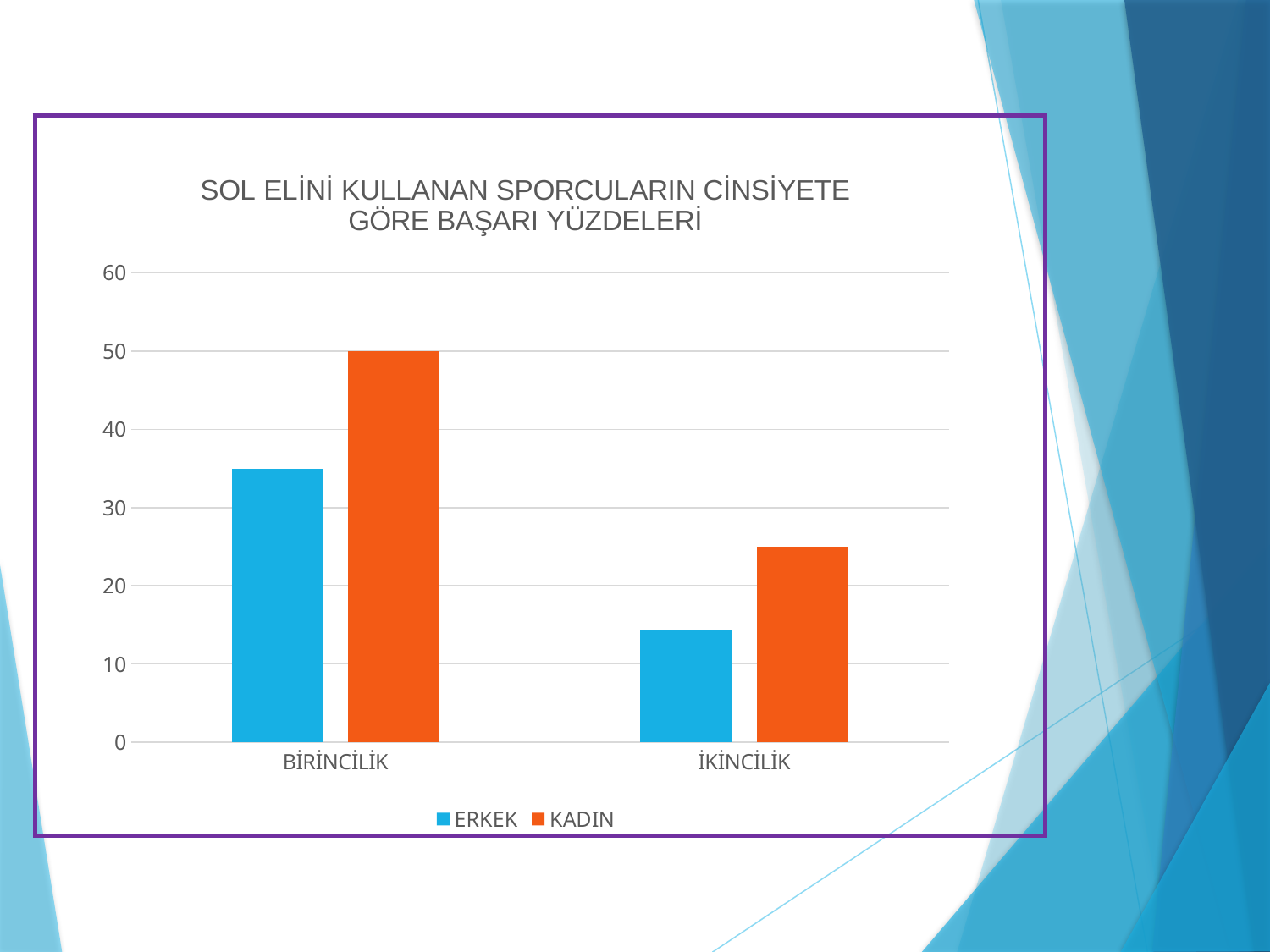
What kind of chart is shown on the slide? bar chart Is the value for ERKEK in the BİRİNCİLİK category greater or less than 30? greater In the İKİNCİLİK category, which series has the larger value, ERKEK or KADIN? KADIN Which bar is the lowest in the chart? ERKEK in İKİNCİLİK How many categories are shown on the x axis? 2 Is the value for KADIN in the İKİNCİLİK category greater or less than 20? greater What is the value for KADIN in the BİRİNCİLİK category? 50 Which colour represents the KADIN series in the legend? orange Is the value for ERKEK in the İKİNCİLİK category greater or less than 20? less Which bar is the highest in the chart? KADIN in BİRİNCİLİK In the BİRİNCİLİK category, which series has the larger value, ERKEK or KADIN? KADIN How many series does the legend list? 2